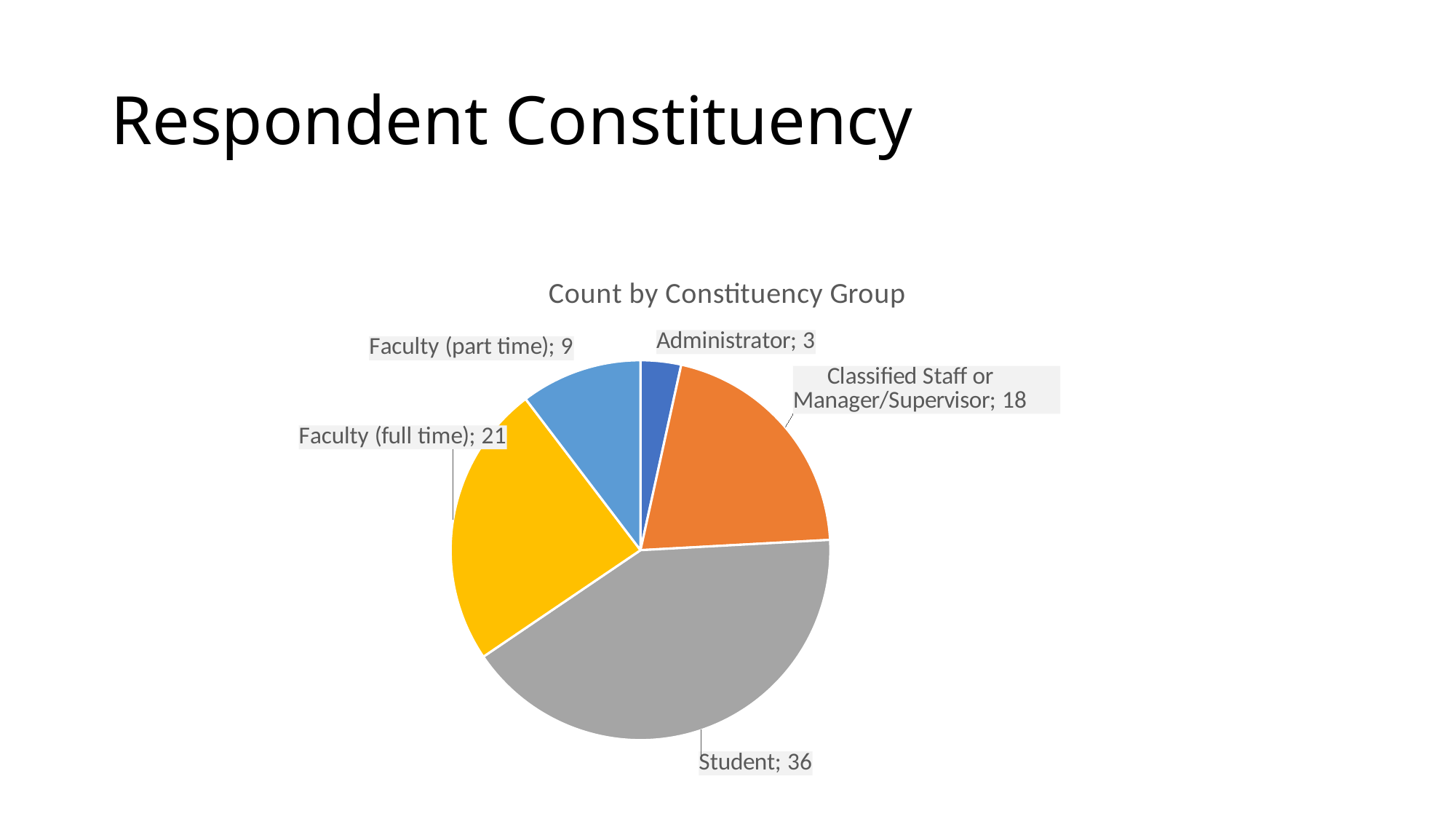
How many constituency groups are shown in the pie chart? 5 What is the total count across all constituency groups? 87 Which constituency group has the smallest slice? Administrator What type of chart is shown on the slide? Pie chart What is the count for Classified Staff or Manager/Supervisor? 18 Which is larger, Faculty (part time) or Classified Staff or Manager/Supervisor? Classified Staff or Manager/Supervisor What is the title of the chart? Count by Constituency Group How many respondents are Students? 36 What is the count for Administrator? 3 What is the count for Faculty (full time)? 21 What is the difference between the Student count and the Faculty (full time) count? 15 Which constituency group has the largest slice? Student